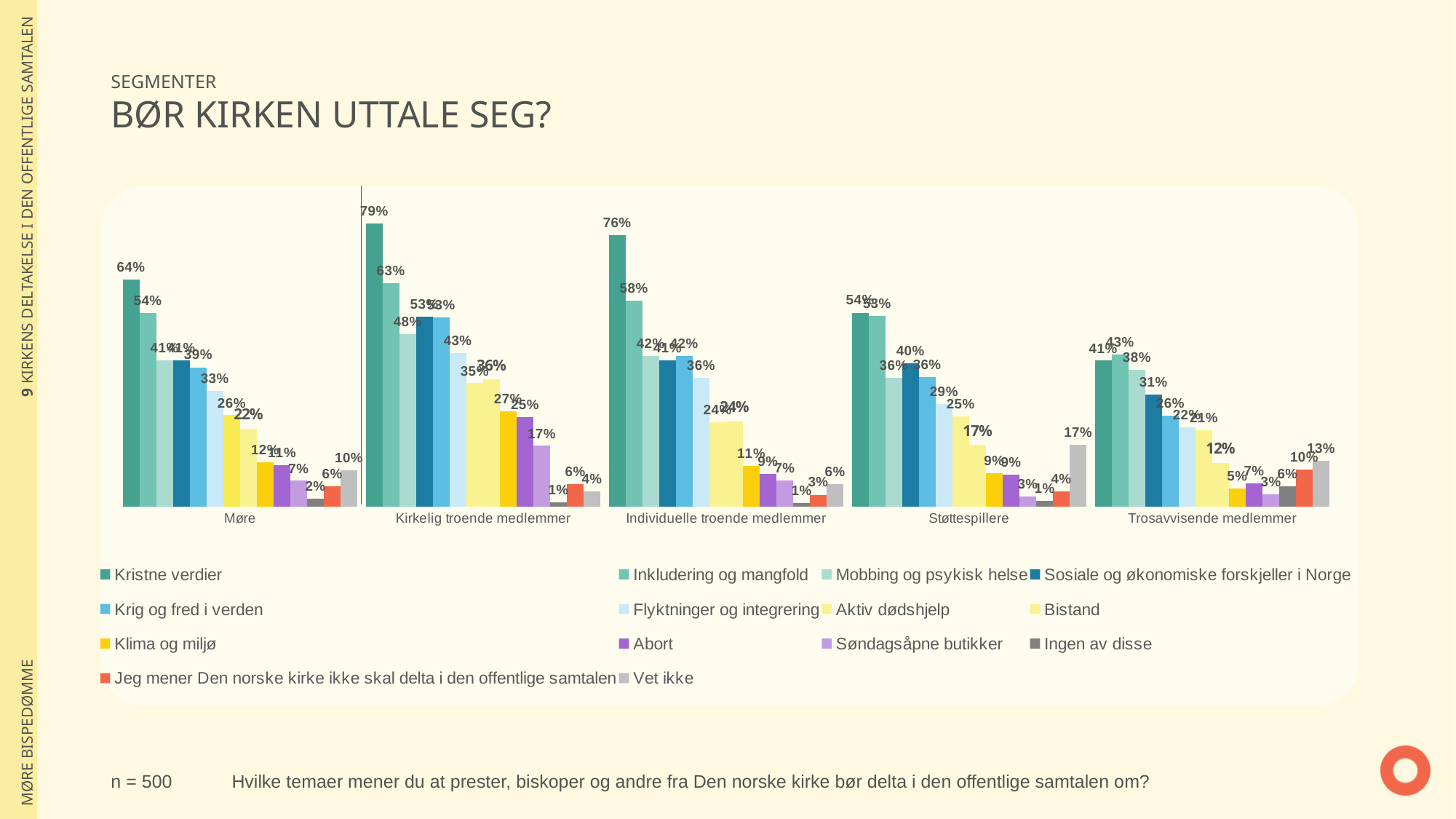
How many series does the chart's legend list? 14 Which is larger: the Kristne verdier value for Individuelle troende medlemmer or for Støttespillere? Individuelle troende medlemmer What kind of chart is shown on the slide? bar chart How many segment categories are shown along the x axis of the chart? 5 Which segment has the highest value for Kristne verdier? Kirkelig troende medlemmer What is the value for Vet ikke in the Støttespillere group? 17% What is the title of the slide above the chart? BØR KIRKEN UTTALE SEG? What is the difference between the Kristne verdier values for Kirkelig troende medlemmer and Møre? 15 percentage points What is the value for Kristne verdier in the Møre group? 64% What is the value for Kristne verdier in the Kirkelig troende medlemmer group? 79% What is the value for Søndagsåpne butikker in the Kirkelig troende medlemmer group? 17% What is the value for Inkludering og mangfold in the Individuelle troende medlemmer group? 58%